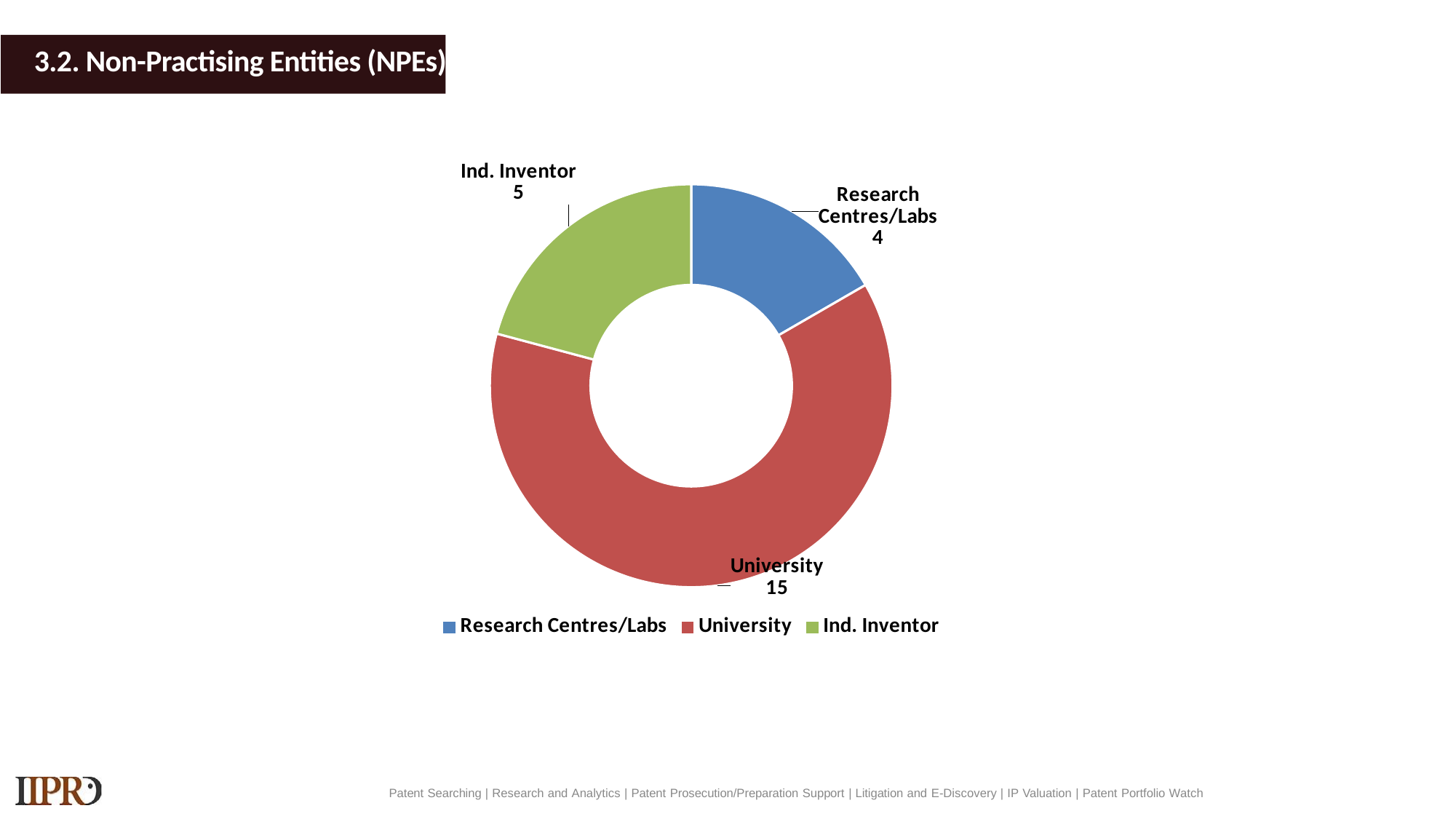
What colour is the University slice? Red Which category has the highest value? University Which is larger, the value for University or the value for Research Centres/Labs? University Which category has the lowest value? Research Centres/Labs What is the difference between the values for Ind. Inventor and Research Centres/Labs? 1 What is the difference between the values for University and Ind. Inventor? 10 What is the value for Ind. Inventor? 5 What kind of chart is shown on the slide? Doughnut chart What is the value for Research Centres/Labs? 4 What is the total of all values shown in the chart? 24 How many categories are shown in the chart? 3 What is the value for University? 15